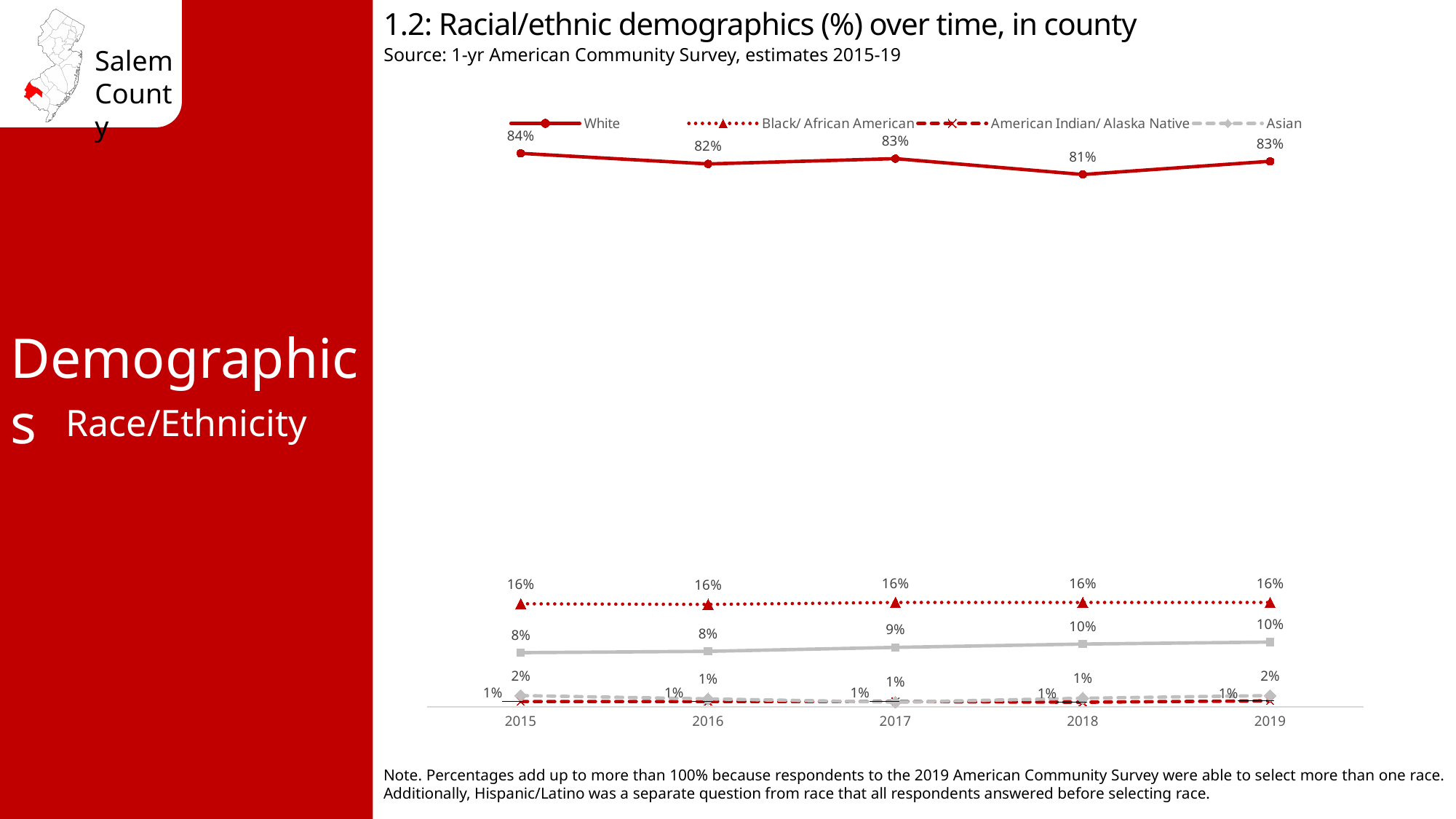
What is the value for White in 2015? 84% How many years are shown on the x axis? 5 Does the Black/ African American line rise, fall, or stay flat from 2015 to 2019? Stays flat What is the value for Black/ African American in 2017? 16% In which year is the White percentage highest? 2015 In which year is the White percentage lowest? 2018 What is the title of the chart? 1.2: Racial/ethnic demographics (%) over time, in county What is the difference between the White value in 2015 and in 2018? 3 percentage points What is the value for Asian in 2019? 2% What kind of chart is shown on the slide? Line chart Which year has the larger White value, 2016 or 2019? 2019 What is the value for White in 2018? 81%